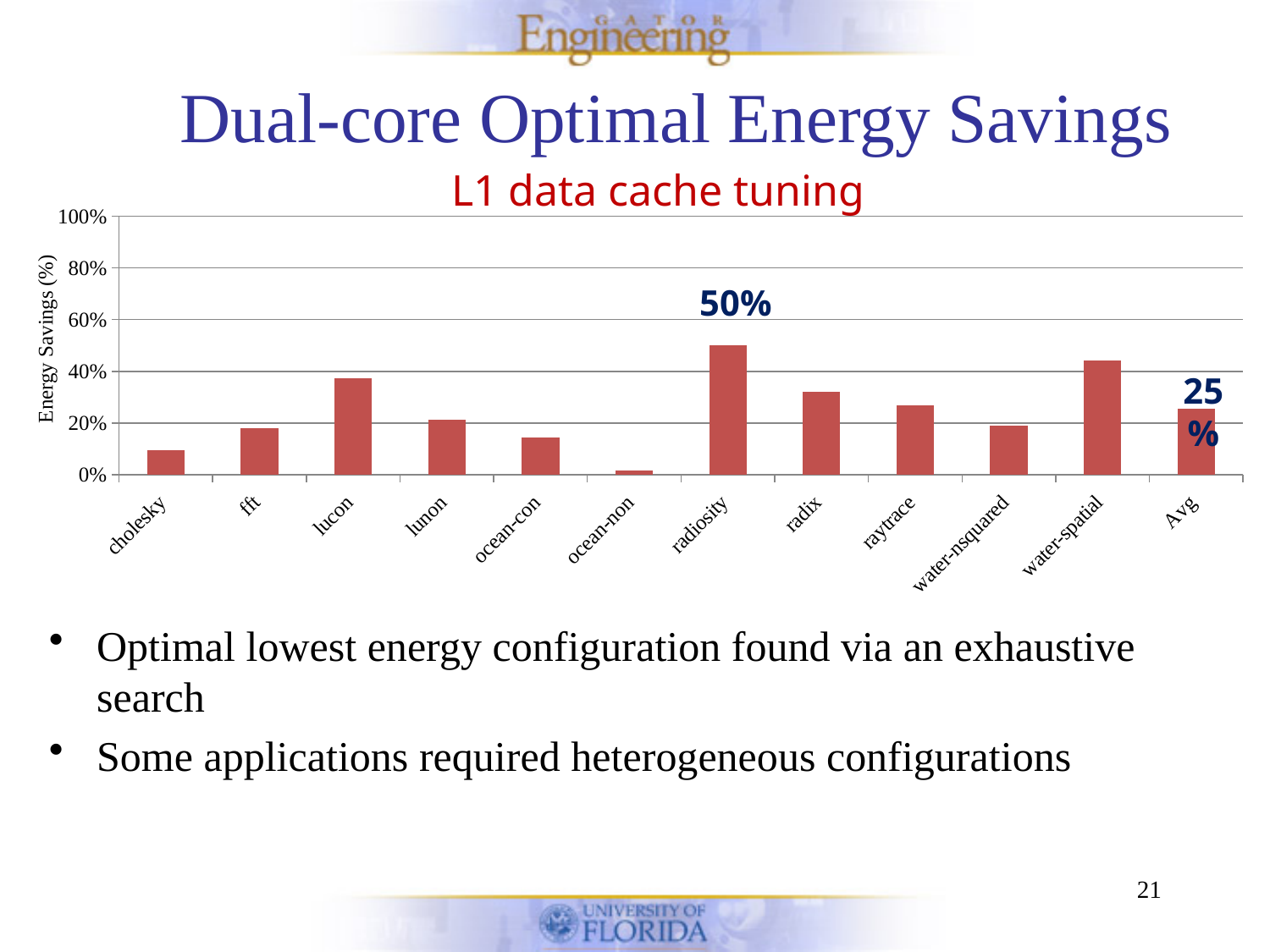
Which has higher energy savings, water-spatial or radix? water-spatial Which application has the highest energy savings? radiosity Is the value for water-spatial greater or less than 40%? greater How many categories are shown on the x axis of the chart? 12 Which application has the lowest energy savings? ocean-non What kind of chart is shown on the slide? bar chart Is the value for cholesky greater or less than 20%? less What is the difference between the energy savings for radiosity and the Avg value? 25% What is the energy savings value for radiosity? 50% Which has higher energy savings, lucon or lunon? lucon What is the energy savings value for Avg? 25% What is the label of the y axis of the chart? Energy Savings (%)